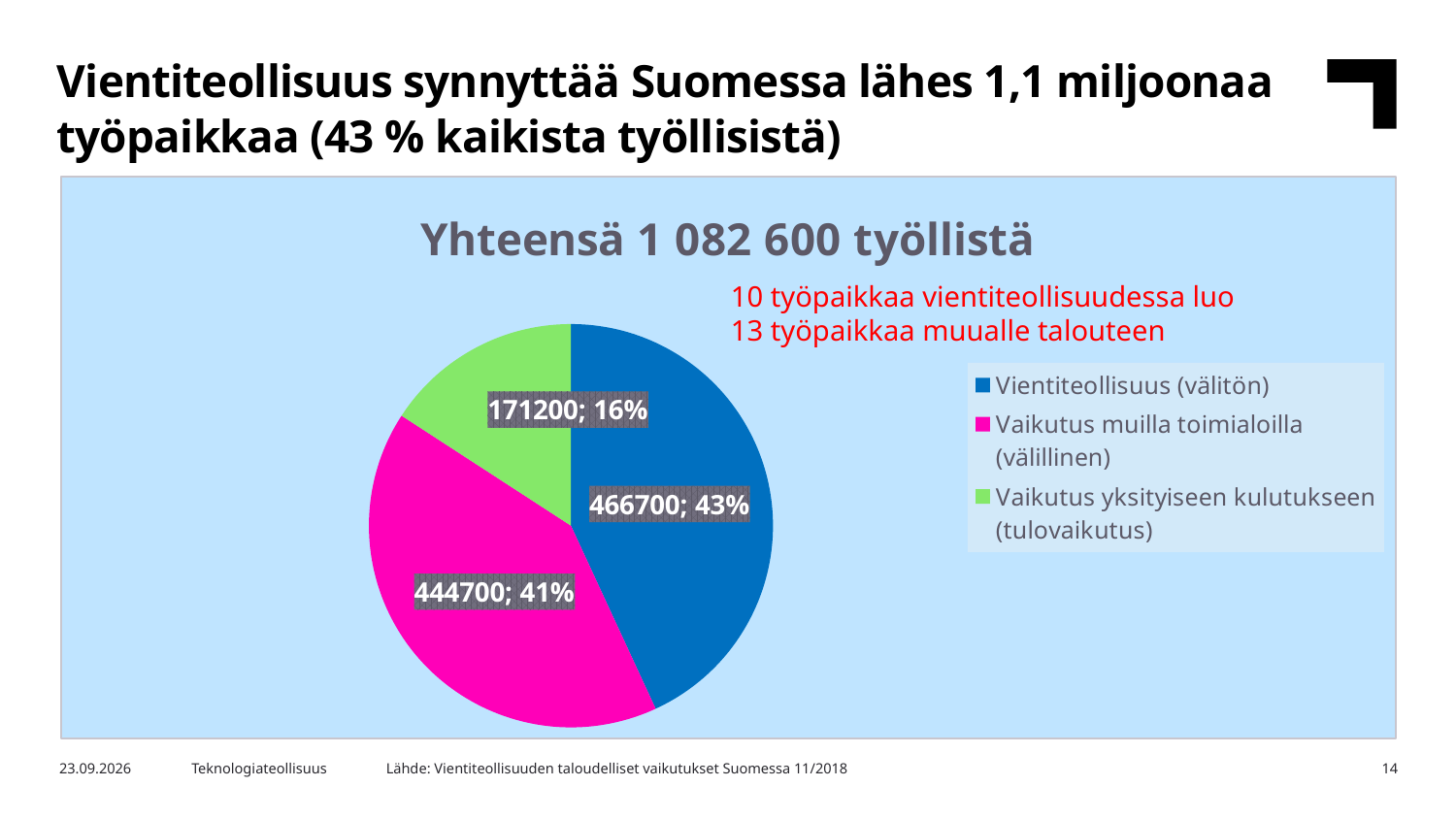
What is the value for Vaikutus muilla toimialoilla (välillinen)? 444700 What share of the pie does Vaikutus yksityiseen kulutukseen (tulovaikutus) represent? 16% What is the difference between the values for Vientiteollisuus (välitön) and Vaikutus muilla toimialoilla (välillinen)? 22000 What is the title of the chart? Yhteensä 1 082 600 työllistä Which slice is the largest? Vientiteollisuus (välitön) How many entries does the legend list? 3 What kind of chart is shown on the slide? Pie chart Which slice is the smallest? Vaikutus yksityiseen kulutukseen (tulovaikutus) How many slices does the pie chart have? 3 What is the value for Vientiteollisuus (välitön)? 466700 What share of the pie does Vientiteollisuus (välitön) represent? 43% What is the value for Vaikutus yksityiseen kulutukseen (tulovaikutus)? 171200